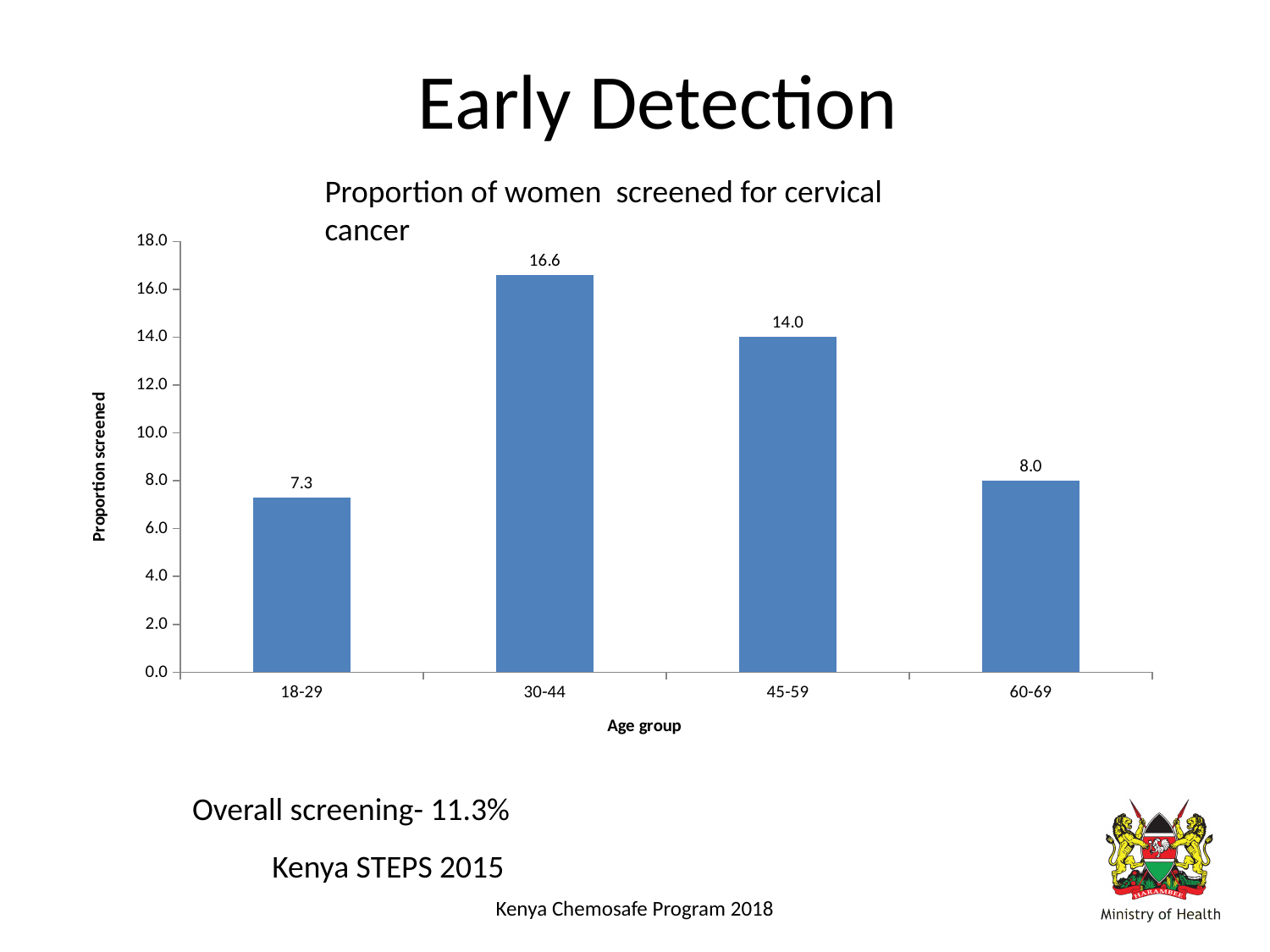
Which age group has the highest proportion of women screened? 30-44 How many age groups are shown on the chart? 4 Is the value for the 45-59 age group greater or less than 12.0? greater What is the label of the x axis? Age group Which age group has a larger proportion screened, 45-59 or 60-69? 45-59 What is the title of the chart? Proportion of women screened for cervical cancer What is the difference between the values for the 30-44 and 45-59 age groups? 2.6 What type of chart is used to show the proportion of women screened? Bar chart What is the value shown for the 60-69 age group? 8.0 What is the proportion of women screened for cervical cancer in the 18-29 age group? 7.3 Which age group has the lowest proportion of women screened? 18-29 What is the proportion of women screened for cervical cancer in the 30-44 age group? 16.6